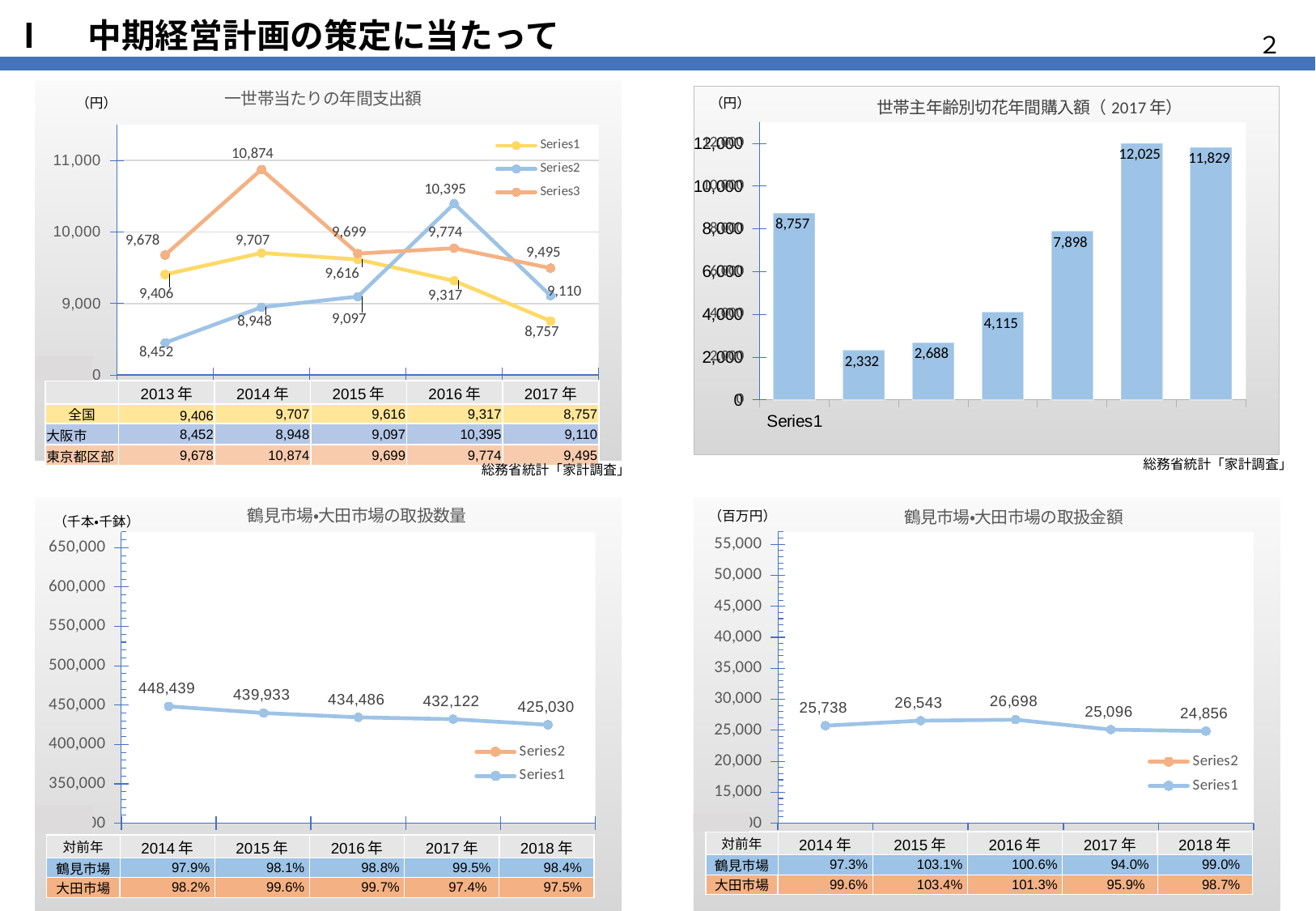
In the chart titled 鶴見市場•大田市場の取扱金額, which is larger, the value for 2016年 or the value for 2017年? 2016年 In the chart titled 世帯主年齢別切花年間購入額（2017年）, what is the highest value shown? 12,025 In the chart titled 一世帯当たりの年間支出額, what is the difference between the 大阪市 value in 2017年 and the 全国 value in 2017年? 353 In the chart titled 世帯主年齢別切花年間購入額（2017年）, what kind of chart is shown? bar chart In the chart titled 一世帯当たりの年間支出額, which year has the lowest value for 全国? 2017年 In the chart titled 世帯主年齢別切花年間購入額（2017年）, how many bars are plotted? 7 In the chart titled 鶴見市場•大田市場の取扱数量, do the plotted values rise or fall from 2014年 to 2018年? fall In the chart titled 鶴見市場•大田市場の取扱数量, what is the value for 2018年? 425,030 In the chart titled 一世帯当たりの年間支出額, how many series does the legend list? 3 In the chart titled 一世帯当たりの年間支出額, what is the value for 東京都区部 in 2014年? 10,874 In the chart titled 一世帯当たりの年間支出額, what is the value for 大阪市 in 2016年? 10,395 In the chart titled 世帯主年齢別切花年間購入額（2017年）, what is the lowest value shown? 2,332